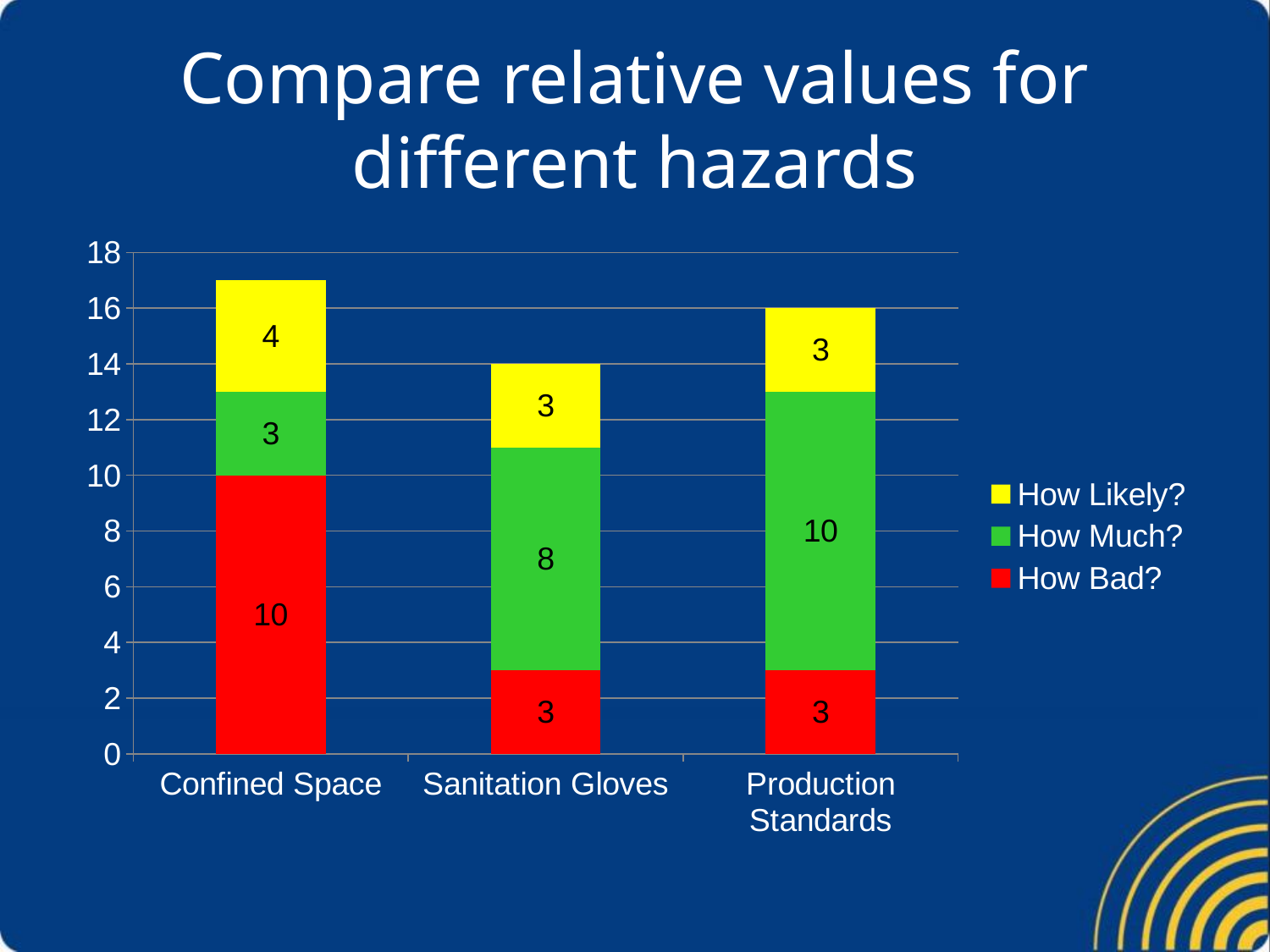
How many hazard categories are shown on the x axis? 3 What is the "How Much?" value for Sanitation Gloves? 8 How many series does the legend list? 3 Which hazard has the highest "How Bad?" value? Confined Space What is the "How Bad?" value for Confined Space? 10 What is the total of the stacked bar for Confined Space? 17 What is the "How Likely?" value for Production Standards? 3 Which is larger: the "How Likely?" value for Confined Space or for Sanitation Gloves? Confined Space Which hazard has the lowest "How Much?" value? Confined Space What is the total of the stacked bar for Sanitation Gloves? 14 What kind of chart is shown on the slide? Stacked bar chart What is the difference between the "How Much?" values for Production Standards and Confined Space? 7